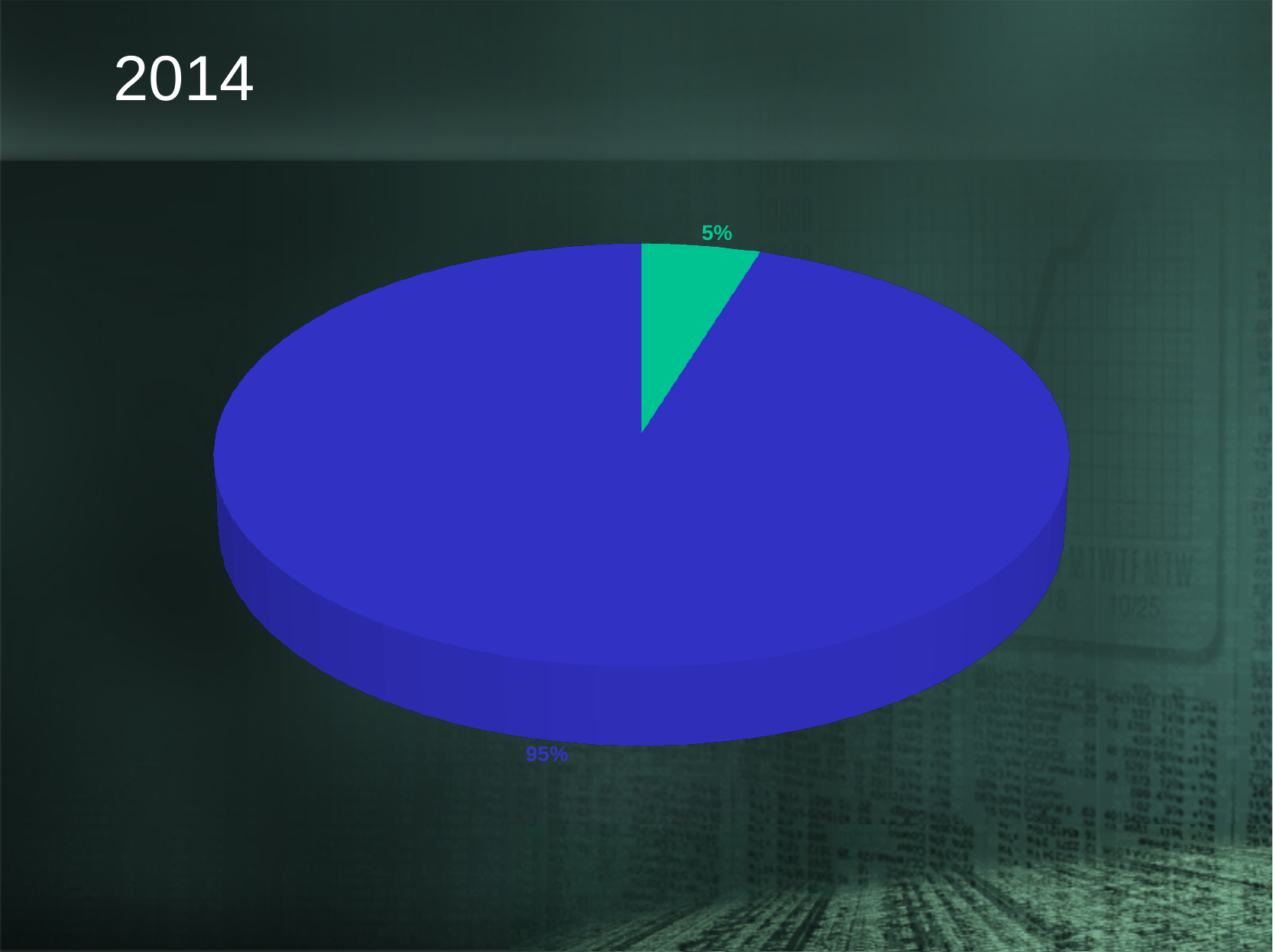
Does the pie chart include a legend? No What share of the pie does the green slice represent? 5% How many slices does the pie chart have? 2 What is the title shown at the top of the slide? 2014 Which slice of the pie chart is the smallest? the green slice (5%) What percentage is shown for the blue slice of the pie chart? 95% Which slice of the pie chart is the largest? the blue slice (95%) What is the difference in percentage points between the blue slice and the green slice? 90 Which is larger, the blue slice or the green slice? the blue slice What percentage is shown for the green slice of the pie chart? 5% What kind of chart is shown on the slide? pie chart